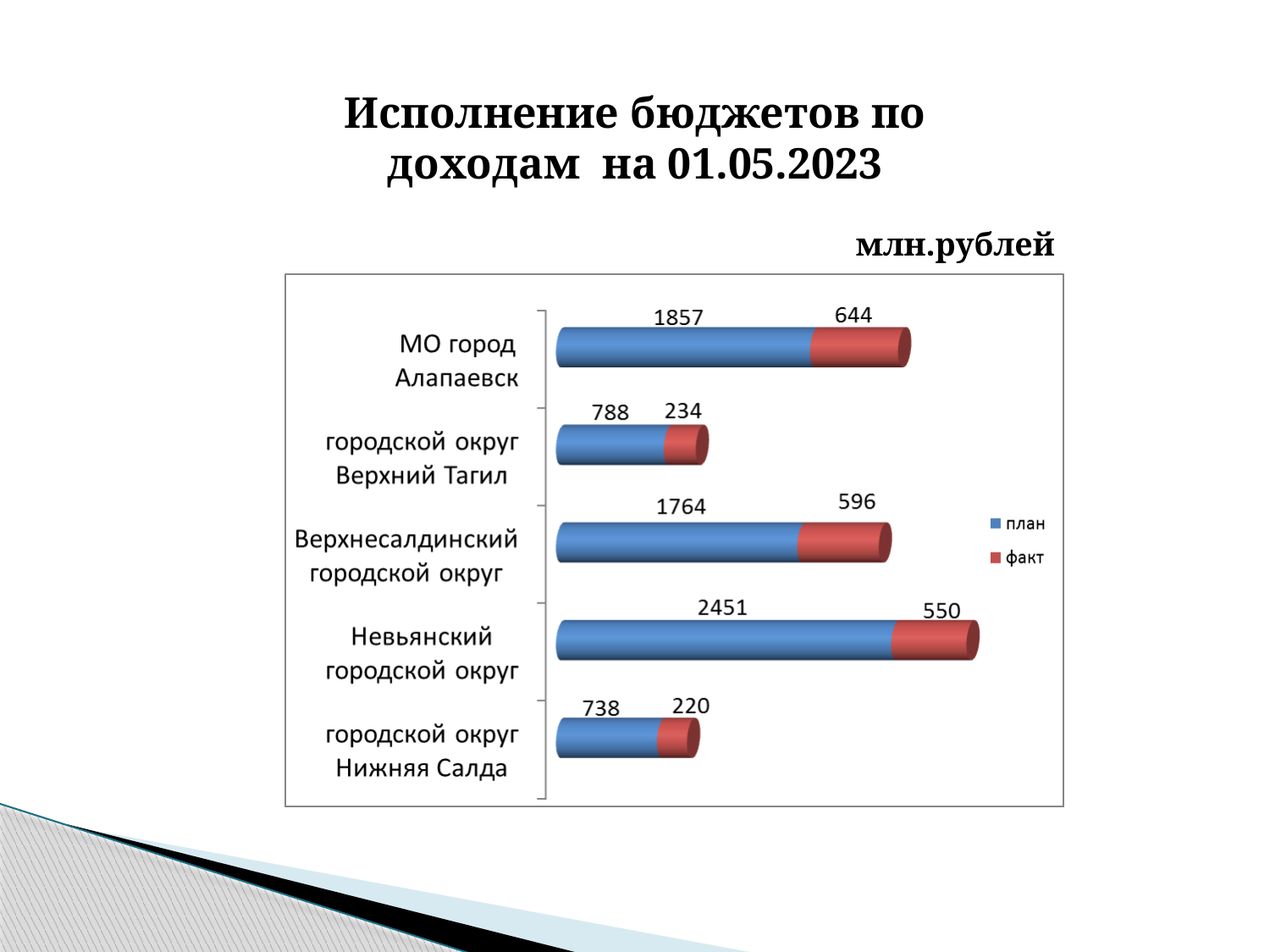
How many categories are shown on the chart? 5 Which colour represents the факт series in the legend? red Which is larger: the факт value for МО город Алапаевск or the факт value for Невьянский городской округ? МО город Алапаевск What is the план value for городской округ Нижняя Салда? 738 What is the план value for Невьянский городской округ? 2451 Which category has the highest план value? Невьянский городской округ What is the факт value for МО город Алапаевск? 644 What is the difference between the план and факт values for Верхнесалдинский городской округ? 1168 What is the total of the stacked bar for городской округ Верхний Тагил? 1022 What kind of chart is shown on the slide? bar chart Which category has the lowest факт value? городской округ Нижняя Салда How many series does the legend list? 2